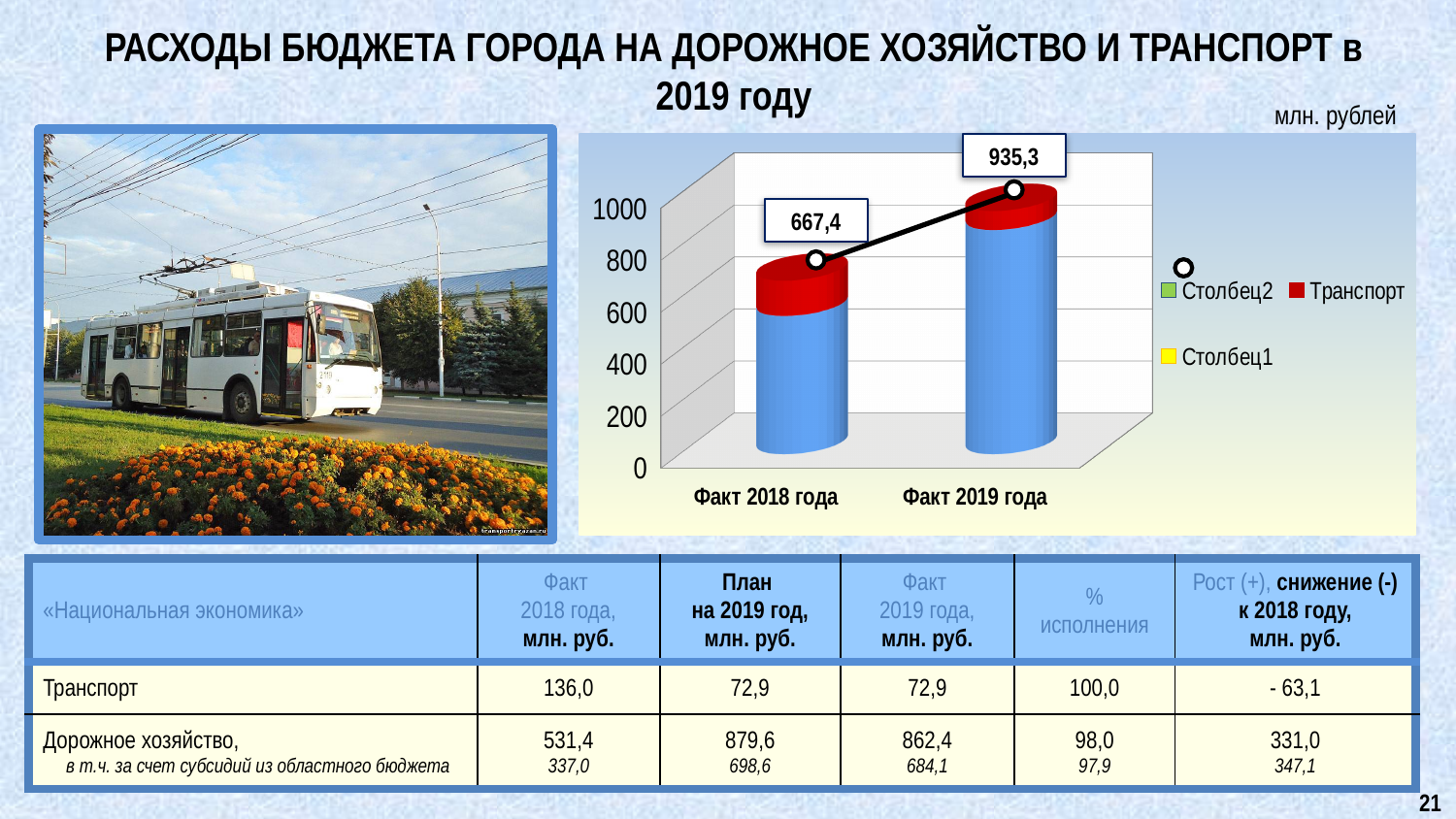
How many entries does the chart legend list? 3 What is the value shown for Факт 2019 года? 935,3 Do the values rise or fall from Факт 2018 года to Факт 2019 года? rise What is the value shown for Факт 2018 года? 667,4 Which category has the highest value? Факт 2019 года Which is larger, the value for Факт 2018 года or for Факт 2019 года? Факт 2019 года Which category has the lowest value? Факт 2018 года How many categories are shown on the x axis of the chart? 2 What is the difference between the values for Факт 2019 года and Факт 2018 года? 267,9 Which legend entry is shown in red? Транспорт What kind of chart is shown on the slide? bar chart What unit is indicated above the chart? млн. рублей